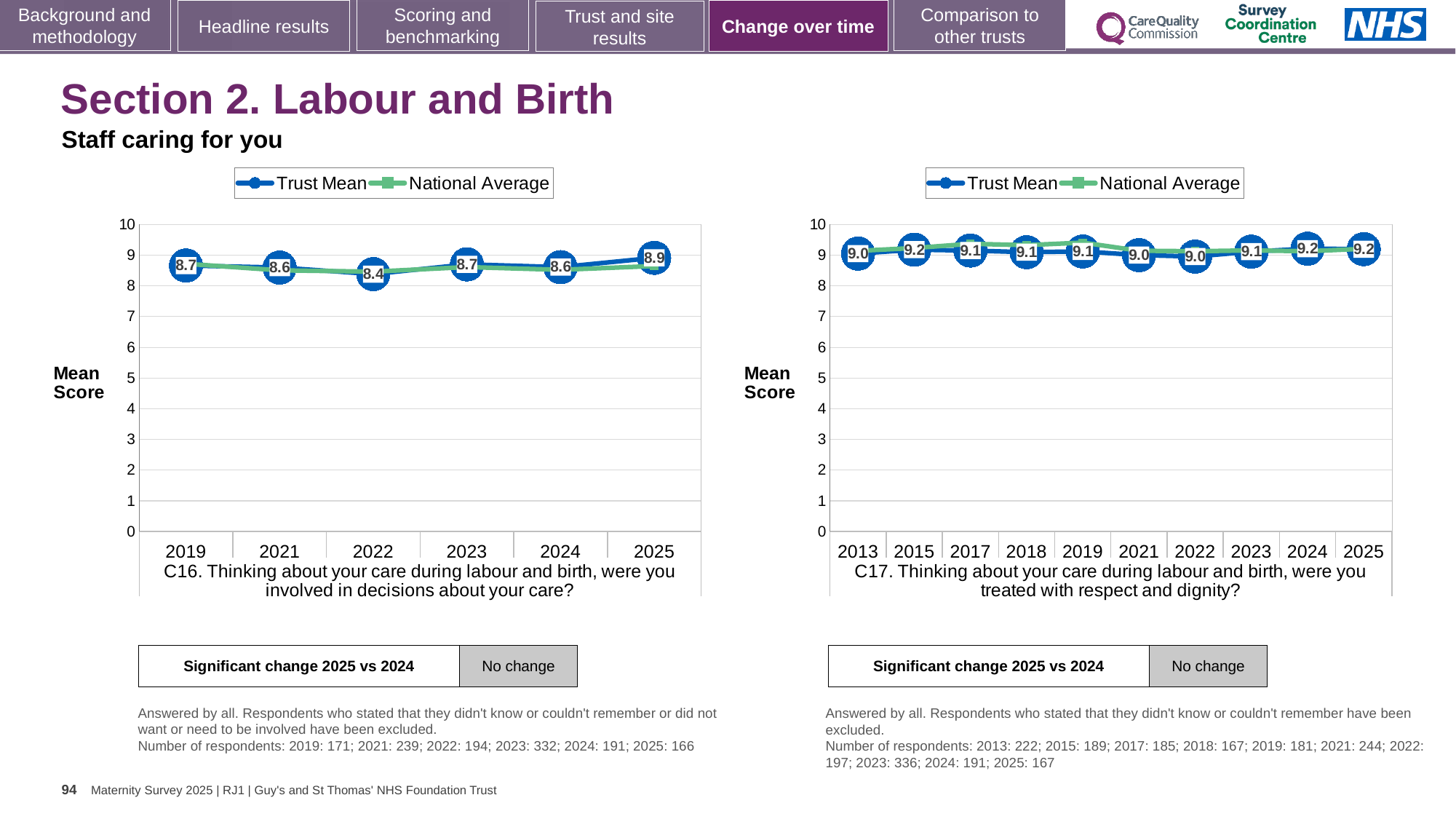
In the C16 chart on the left, what is the Trust Mean score for 2022? 8.4 What kind of chart is the C16 chart on the left? Line chart In the C17 chart on the right, what is the Trust Mean score for 2025? 9.2 In the C16 chart on the left, is the Trust Mean score higher in 2025 or in 2022? 2025 In the C16 chart on the left, what is the Trust Mean score for 2025? 8.9 In the C17 chart on the right, is the National Average for 2019 greater or less than 8? greater How many years are shown on the x axis of the C17 chart on the right? 10 In the C16 chart on the left, what is the difference between the Trust Mean scores for 2025 and 2022? 0.5 In the C16 chart on the left, which year has the highest Trust Mean score? 2025 How many series does the legend of the C16 chart on the left list? 2 In the C16 chart on the left, which year has the lowest Trust Mean score? 2022 In the C17 chart on the right, what is the Trust Mean score for 2013? 9.0